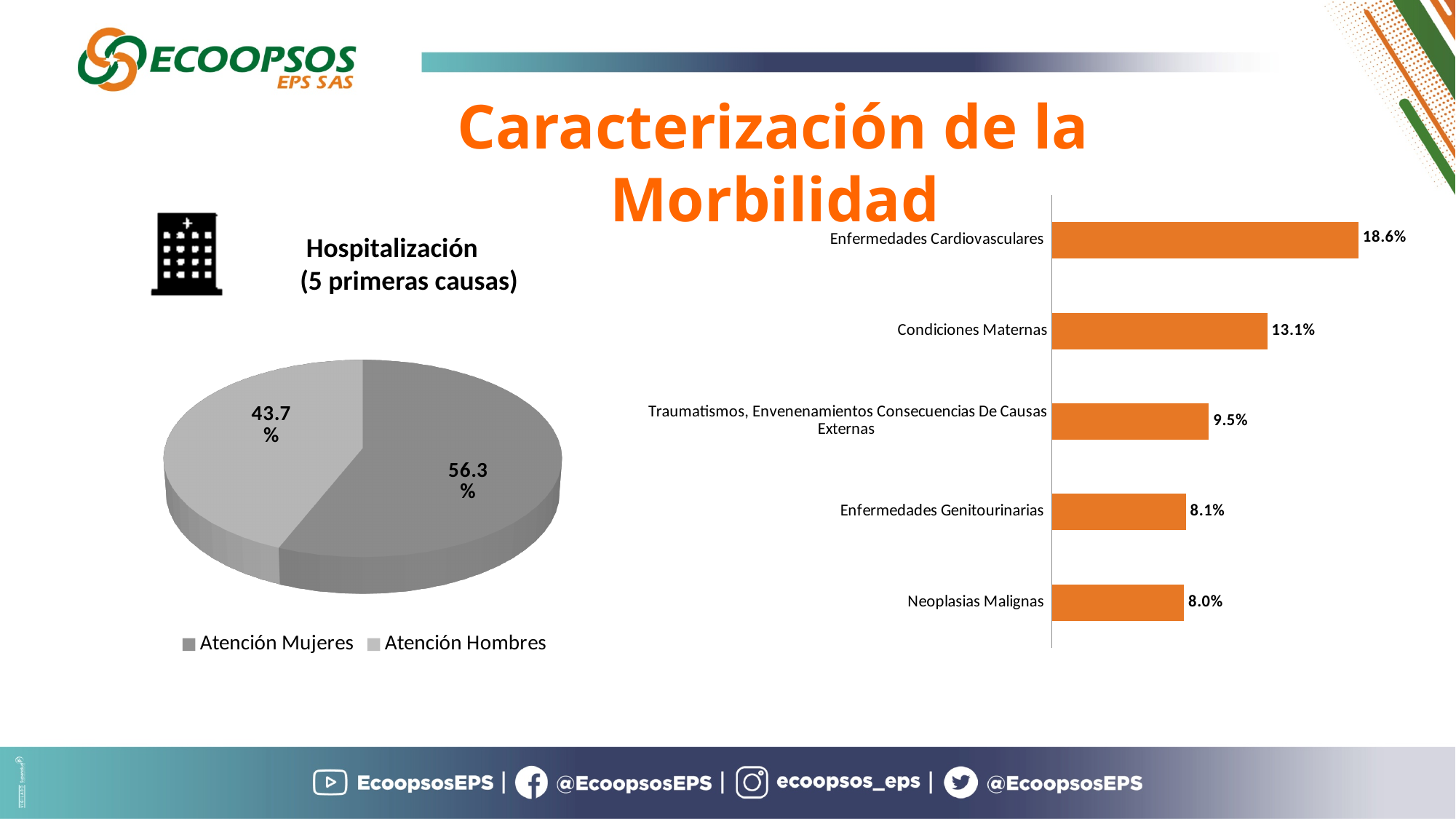
In the bar chart on the right, what is the value for Condiciones Maternas? 13.1% What kind of chart is shown on the left of the slide? Pie chart In the bar chart on the right, which category has the highest value? Enfermedades Cardiovasculares In the pie chart on the left, how many entries does the legend list? 2 In the pie chart on the left, what is the difference between the Atención Mujeres and Atención Hombres shares? 12.6% In the pie chart on the left, which slice is larger, Atención Mujeres or Atención Hombres? Atención Mujeres In the bar chart on the right, which category has the lowest value? Neoplasias Malignas In the bar chart on the right, what is the difference between Enfermedades Cardiovasculares and Condiciones Maternas? 5.5% In the pie chart on the left, what share is labelled for Atención Mujeres? 56.3% In the bar chart on the right, how many categories are shown? 5 In the bar chart on the right, what is the value for Enfermedades Cardiovasculares? 18.6% In the pie chart on the left, what share is labelled for Atención Hombres? 43.7%